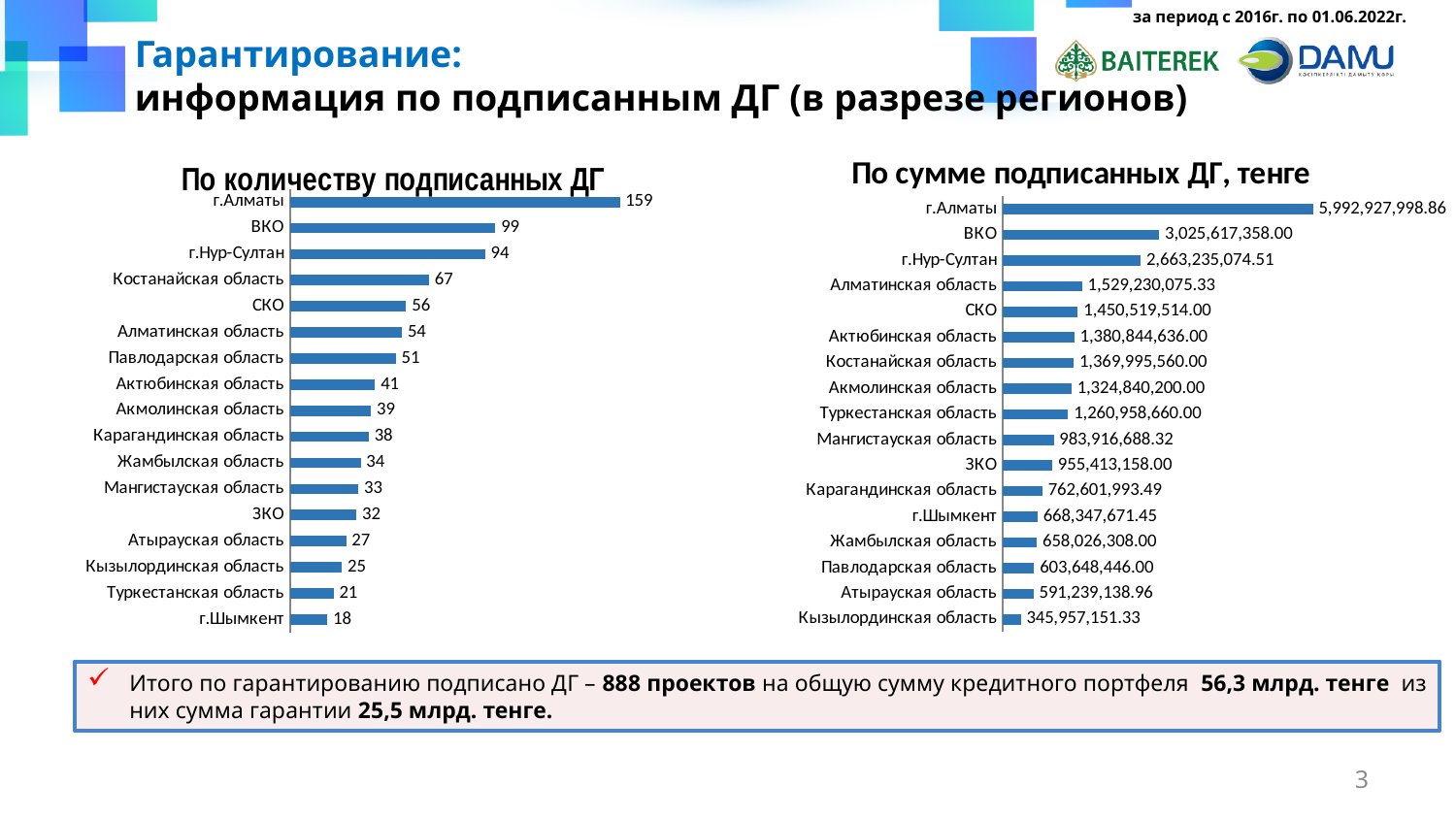
In the chart 'По количеству подписанных ДГ', what is the difference between the values for ВКО and г.Нур-Султан? 5 In the chart 'По количеству подписанных ДГ', what is the value for г.Алматы? 159 In the chart 'По сумме подписанных ДГ, тенге', what is the value for г.Алматы? 5,992,927,998.86 What type of chart is 'По количеству подписанных ДГ'? Bar chart In the chart 'По сумме подписанных ДГ, тенге', which category has the highest value? г.Алматы In the chart 'По сумме подписанных ДГ, тенге', what is the value for Кызылординская область? 345,957,151.33 In the chart 'По количеству подписанных ДГ', what is the value for Костанайская область? 67 In the chart 'По сумме подписанных ДГ, тенге', which is larger: the value for СКО or the value for Актюбинская область? СКО What is the title of the chart on the right side of the slide? По сумме подписанных ДГ, тенге In the chart 'По количеству подписанных ДГ', how many categories are shown? 17 In the chart 'По количеству подписанных ДГ', which category has the lowest value? г.Шымкент In the chart 'По сумме подписанных ДГ, тенге', what is the value for Мангистауская область? 983,916,688.32